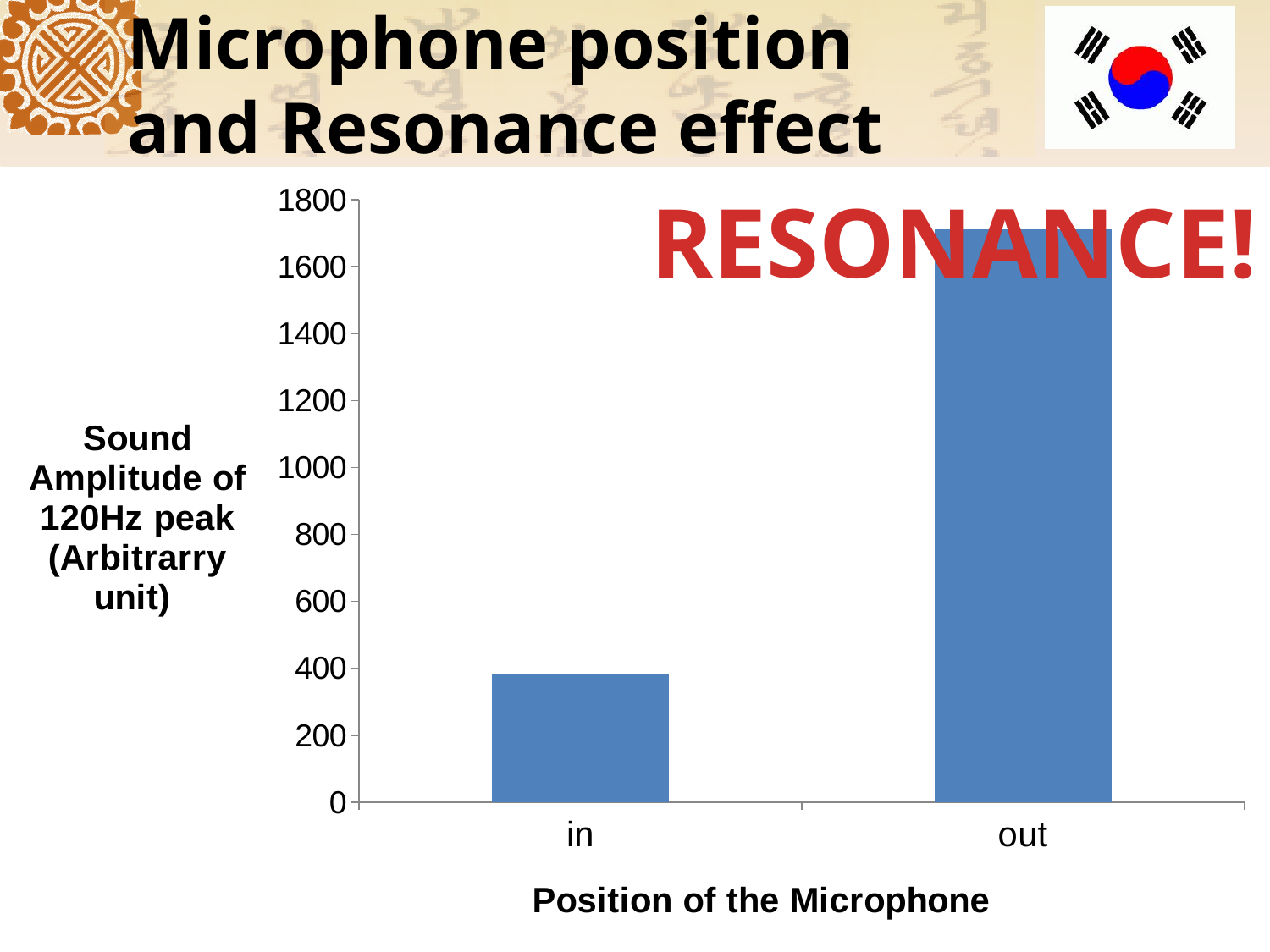
What word is written in large red letters over the chart? RESONANCE! What kind of chart is shown on the slide? bar chart How many microphone positions are plotted on the x axis? 2 Is the sound amplitude for the 'out' position greater or less than 1600? greater Which has a larger sound amplitude, the 'in' position or the 'out' position? out Which microphone position has the lowest sound amplitude? in Is the sound amplitude for the 'in' position greater or less than 200? greater Is the sound amplitude for the 'out' position greater or less than 1800? less Which microphone position has the highest sound amplitude? out What is the label of the x axis? Position of the Microphone